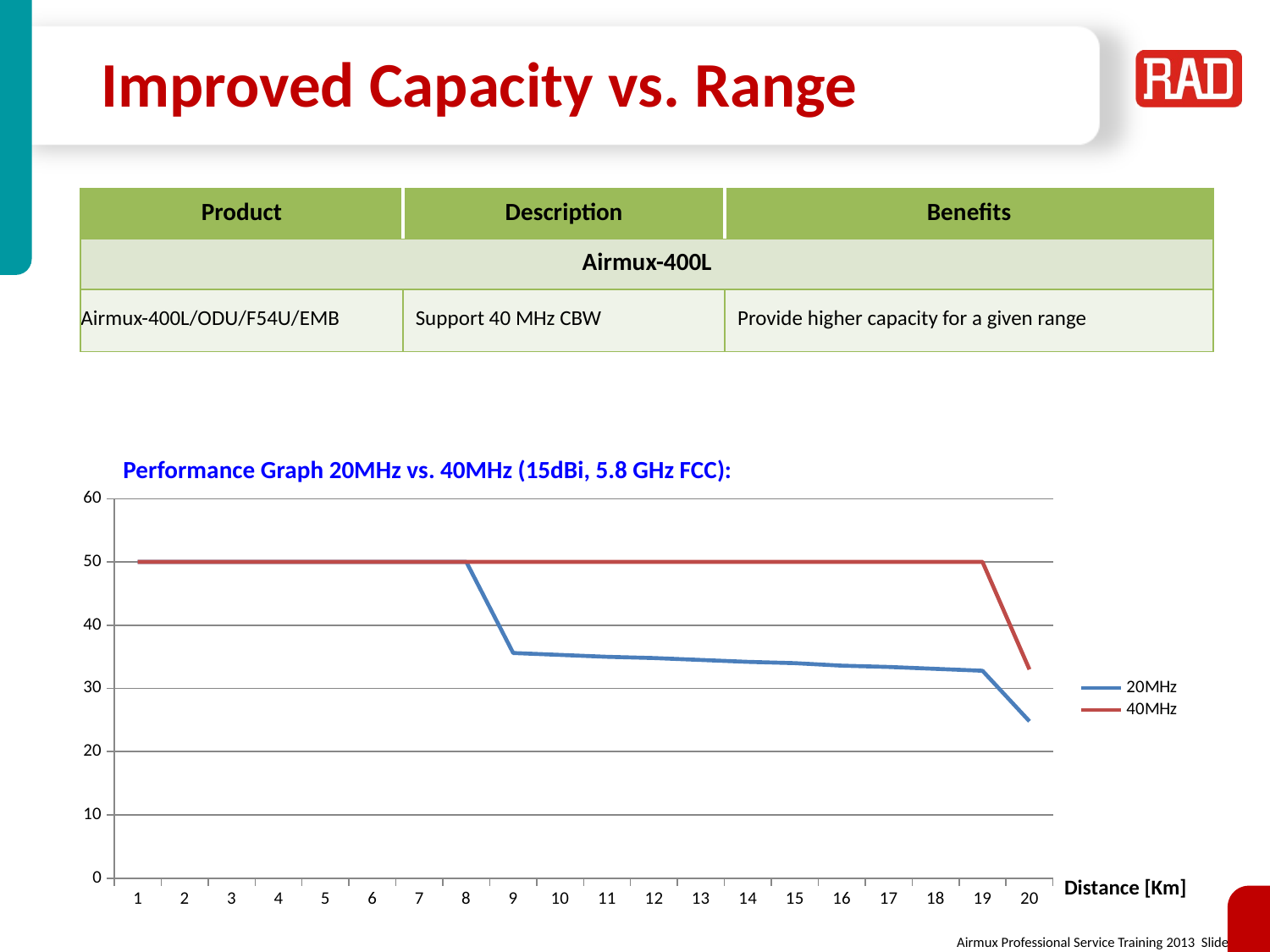
At a distance of 15 km, which series has the higher value, 20MHz or 40MHz? 40MHz Is the value of the 20MHz series at 12 km greater or less than 40? less What is the value of the 40MHz series at a distance of 10 km? 50 What is the label of the x axis of the chart? Distance [Km] What are the two series named in the chart legend? 20MHz and 40MHz What is the value of the 20MHz series at a distance of 5 km? 50 Is the value of the 40MHz series at 18 km greater or less than 40? greater How many distance points are marked along the x axis? 20 How many series does the chart legend list? 2 Is the value of the 20MHz series at 20 km greater or less than 30? less What kind of chart is shown on the slide? line chart Does the 20MHz series rise or fall as distance increases from 8 km to 20 km? fall